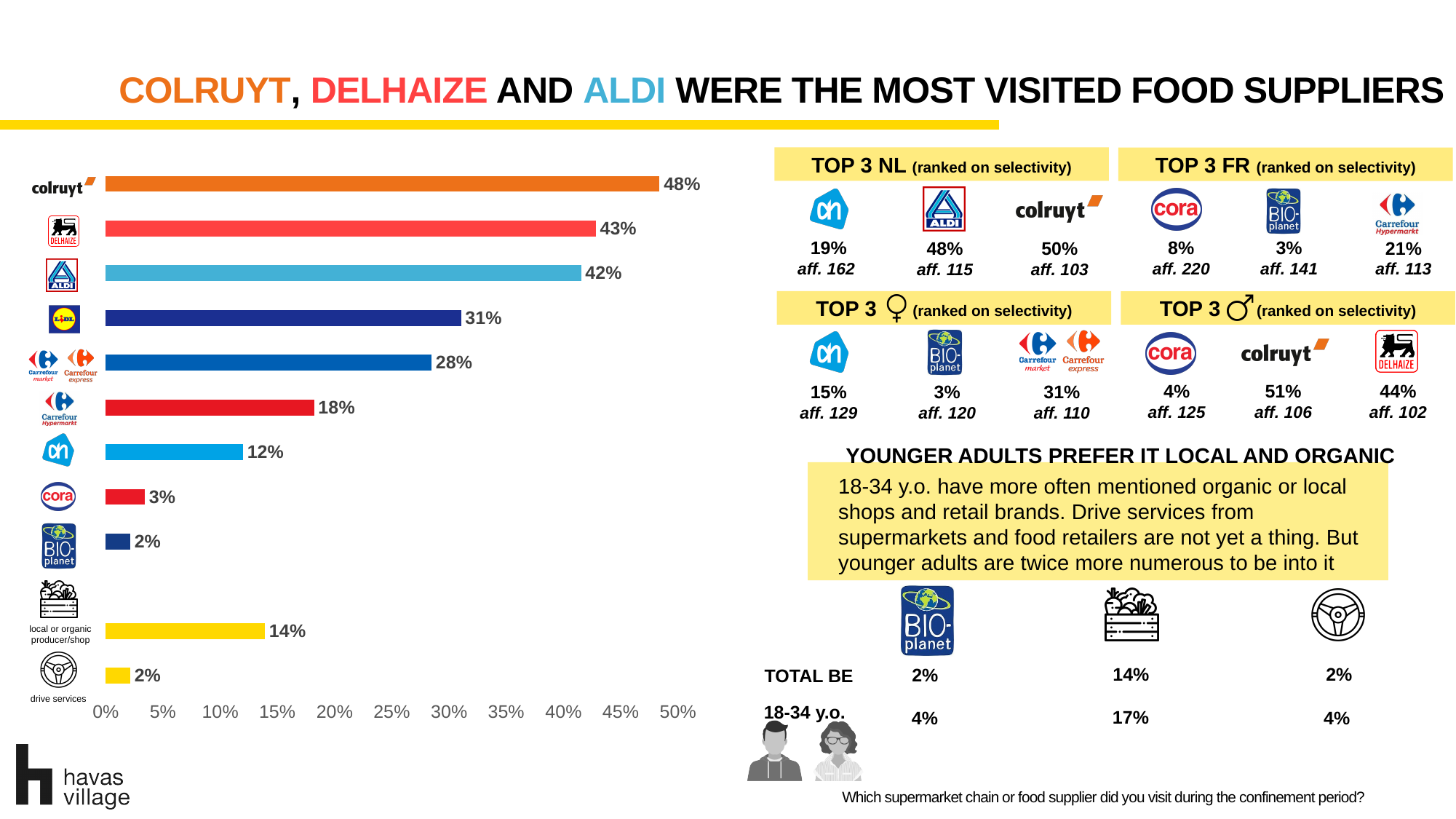
What is the difference between the Delhaize and Lidl values in the bar chart? 12% How many bars are plotted in the bar chart? 11 What is the highest value shown on the x axis of the bar chart? 50% Which food supplier has the highest value in the bar chart? Colruyt What percentage of respondents visited Colruyt according to the bar chart? 48% What is the value for 'local or organic producer/shop' in the bar chart? 14% What is the difference between the values for Colruyt and Aldi in the bar chart? 6% What type of chart is used to show the food suppliers visited? Bar chart Which has a larger value in the bar chart, Carrefour Hypermarket or Cora? Carrefour Hypermarket What value does the bar chart show for Lidl? 31% What is the value shown for Delhaize in the bar chart? 43% What value is shown for 'drive services' in the bar chart? 2%